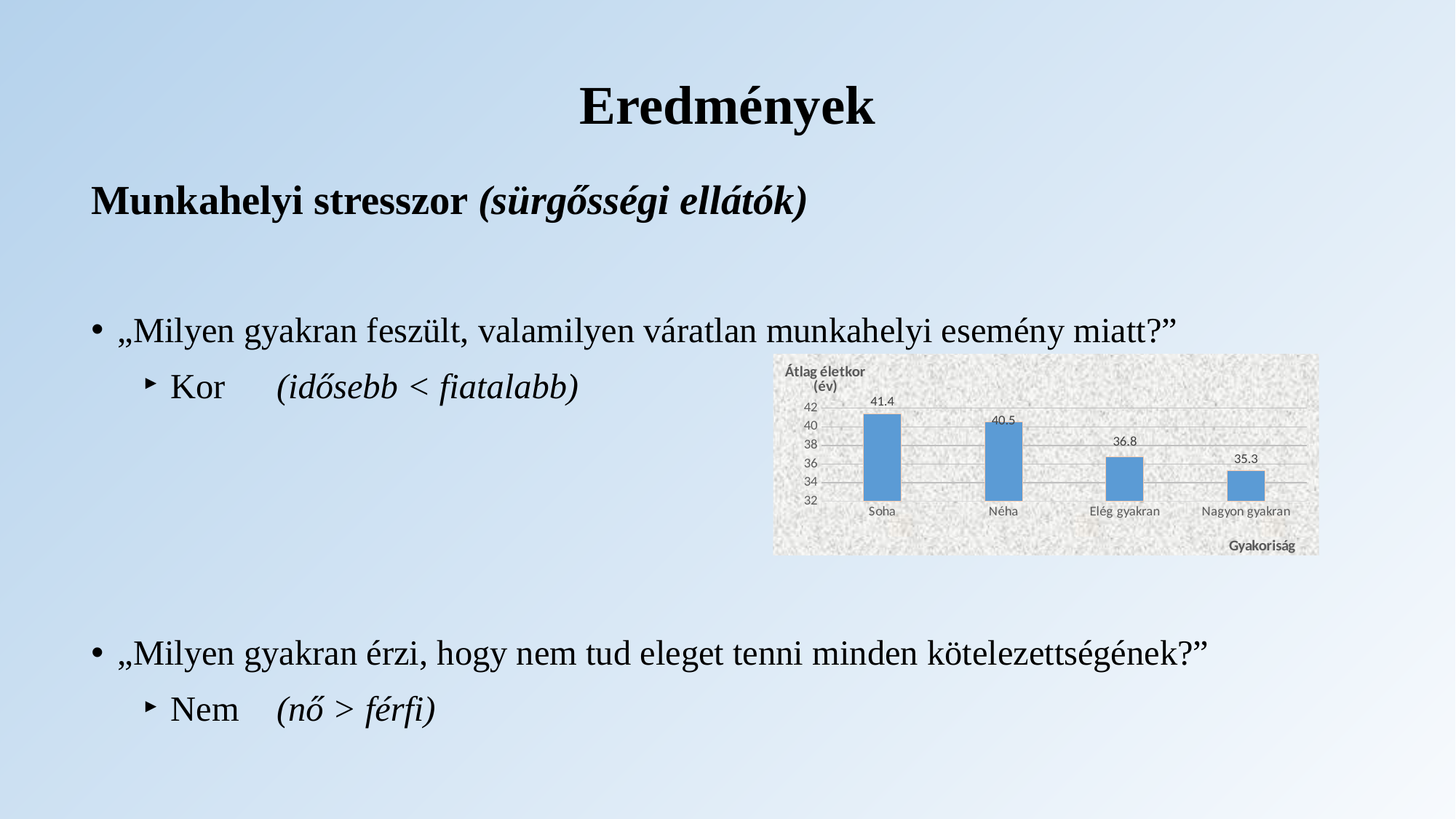
What kind of chart is shown on the slide? Bar chart What is the average age shown for 'Nagyon gyakran'? 35.3 What is the difference in average age between 'Soha' and 'Nagyon gyakran'? 6.1 Do the values rise or fall from left to right along the x axis? Fall How many categories are shown on the x axis of the chart? 4 Which category has the highest average age? Soha Which category has the lowest average age? Nagyon gyakran What is the average age shown for 'Elég gyakran'? 36.8 What is the average age shown for 'Néha'? 40.5 Which has a higher average age, 'Néha' or 'Elég gyakran'? Néha What is the difference in average age between 'Néha' and 'Elég gyakran'? 3.7 What is the average age (Átlag életkor) for the 'Soha' category? 41.4